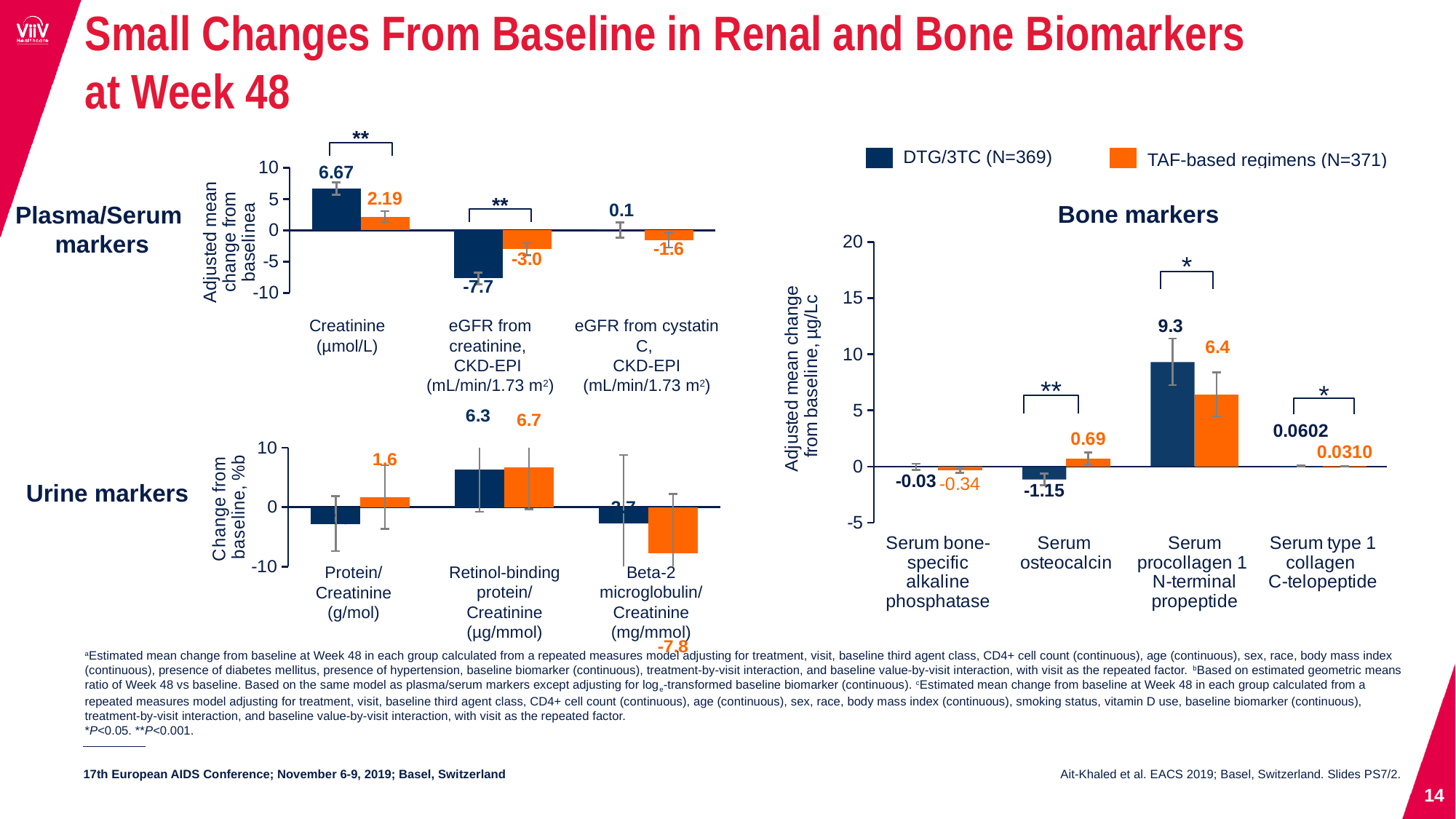
In the Bone markers chart, what is the DTG/3TC value for serum procollagen 1 N-terminal propeptide? 9.3 In the Plasma/Serum markers chart, which category has the lowest DTG/3TC value? eGFR from creatinine, CKD-EPI In the Bone markers chart, which category has the highest value for TAF-based regimens? Serum procollagen 1 N-terminal propeptide What kind of chart is the Bone markers chart? Bar chart In the Bone markers chart, for serum osteocalcin, which series has the larger value: DTG/3TC or TAF-based regimens? TAF-based regimens How many series does the legend list for the charts on this slide? 2 In the Plasma/Serum markers chart, what is the difference between the DTG/3TC and TAF-based regimens values for creatinine? 4.48 In the Bone markers chart, what is the difference between the DTG/3TC and TAF-based regimens values for serum procollagen 1 N-terminal propeptide? 2.9 In the Plasma/Serum markers chart, what is the adjusted mean change from baseline in creatinine for DTG/3TC? 6.67 In the Bone markers chart, how many bone marker categories are shown on the x axis? 4 In the Urine markers chart, what is the TAF-based regimens value for retinol-binding protein/creatinine? 6.7 In the Plasma/Serum markers chart, what is the value for TAF-based regimens for eGFR from creatinine, CKD-EPI? -3.0